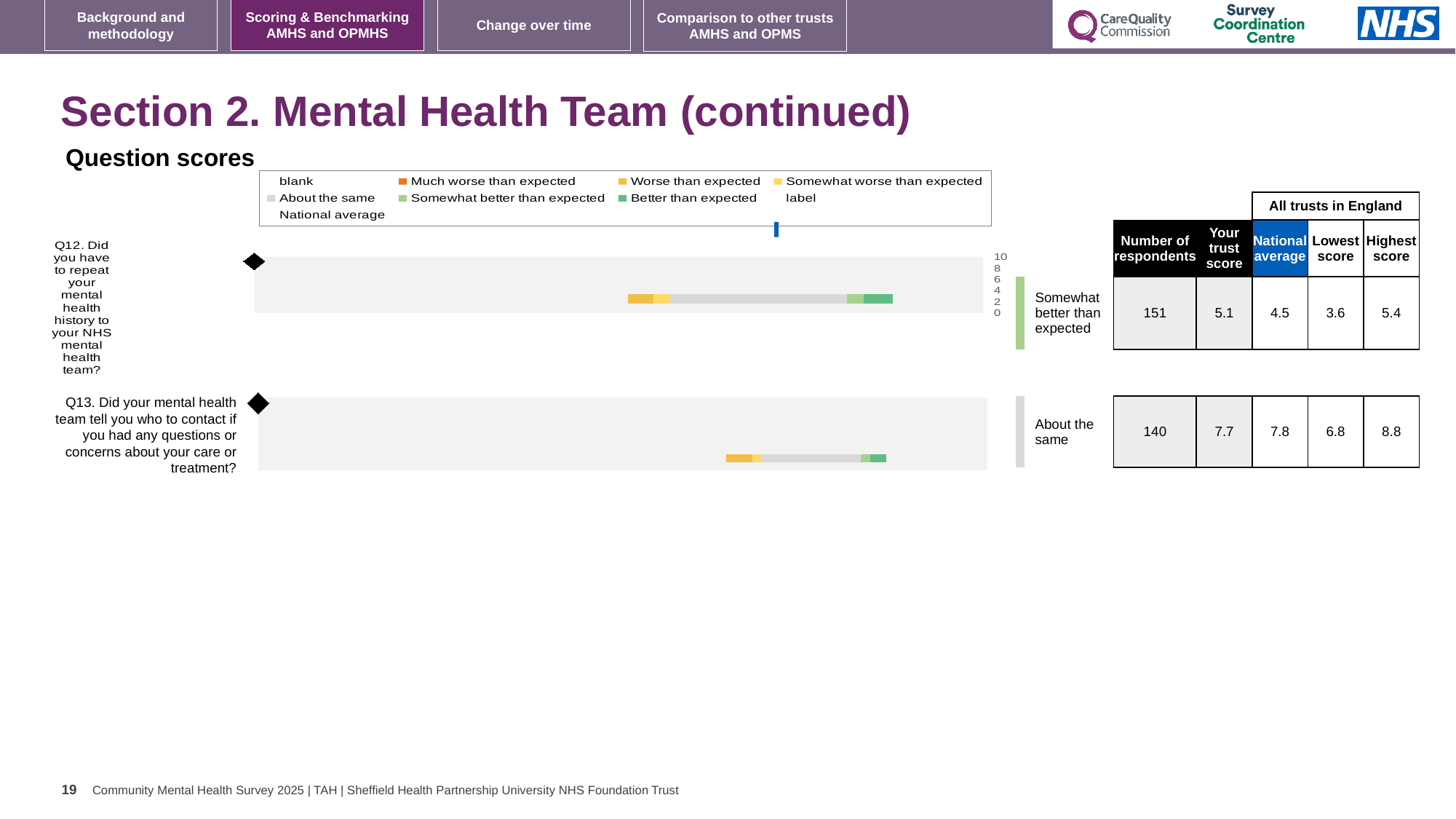
What is the national average for Q13 (who to contact with questions or concerns)? 7.8 In the legend, what colour represents 'Much worse than expected'? orange What is the trust score for Q12 (repeating mental health history)? 5.1 How many questions are plotted in the question scores chart? 2 Which benchmark category is shown for Q13? About the same What is the number of respondents for Q12 (repeating mental health history)? 151 For Q12, which is larger: the trust score or the national average? trust score (5.1) What is the highest score across all trusts in England for Q12? 5.4 Which benchmark category is shown for Q12? Somewhat better than expected What type of chart is used to show the question scores for Q12 and Q13? bar chart Which question has the higher trust score, Q12 or Q13? Q13 For Q13, what is the difference between the highest score and the lowest score across all trusts in England? 2.0